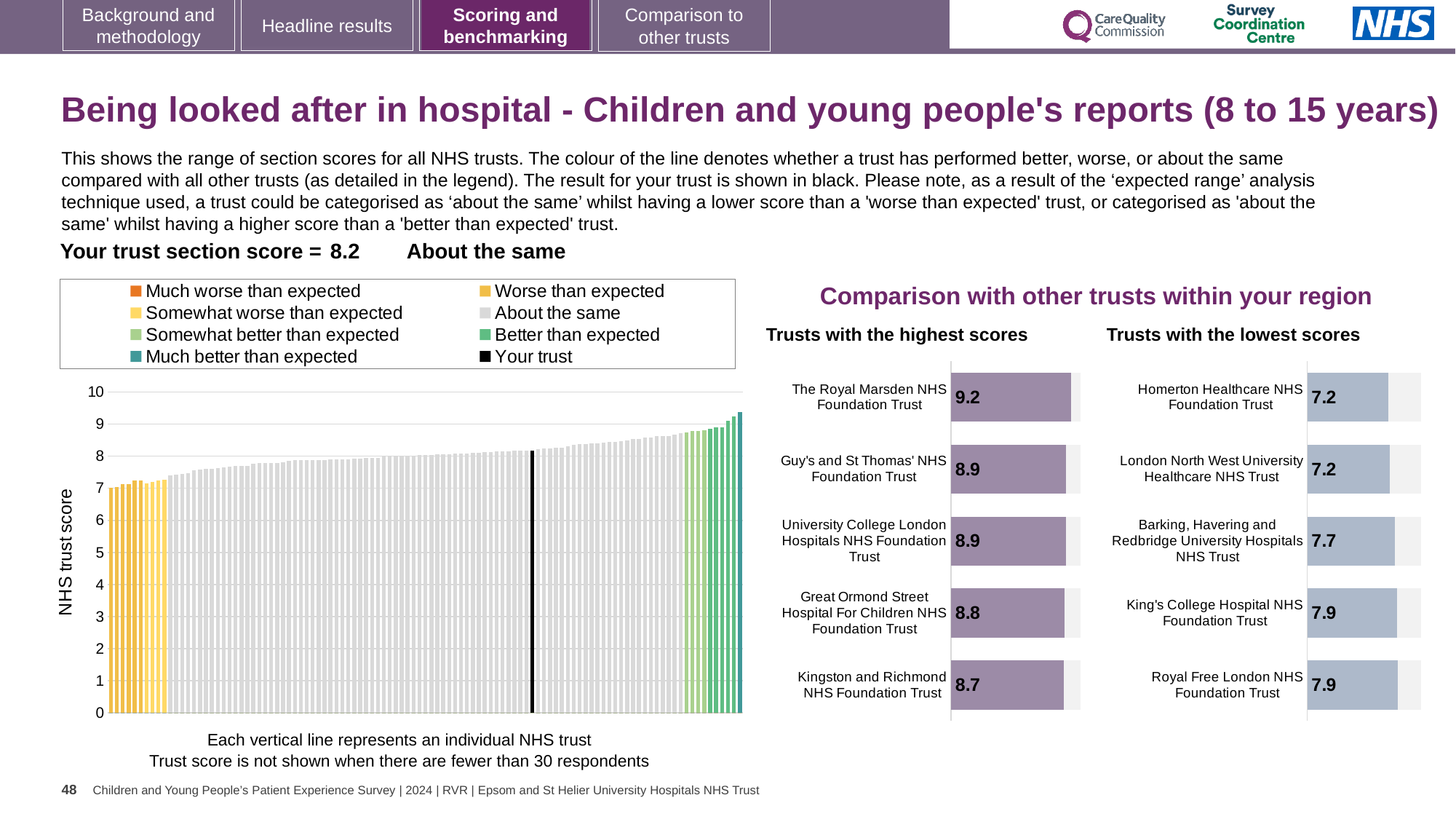
In the 'Trusts with the highest scores' chart, what is the score for Kingston and Richmond NHS Foundation Trust? 8.7 How many trusts are listed in the 'Trusts with the lowest scores' chart? 5 In the 'NHS trust score' chart on the left, do the bar values rise or fall from left to right? Rise How many entries does the legend above the 'NHS trust score' chart list? 8 In the 'NHS trust score' chart on the left, is the value of the tallest bar greater or less than 10? less In the 'Trusts with the lowest scores' chart, what is the score for Barking, Havering and Redbridge University Hospitals NHS Trust? 7.7 In the 'Trusts with the lowest scores' chart, what is the difference between the scores of Royal Free London NHS Foundation Trust and Homerton Healthcare NHS Foundation Trust? 0.7 What kind of chart is the 'NHS trust score' chart on the left of the slide? Bar chart In the 'Trusts with the highest scores' chart, what is the score for The Royal Marsden NHS Foundation Trust? 9.2 In the 'Trusts with the lowest scores' chart, which has the larger score: Barking, Havering and Redbridge University Hospitals NHS Trust or King's College Hospital NHS Foundation Trust? King's College Hospital NHS Foundation Trust In the 'Trusts with the highest scores' chart, what is the difference between the scores of The Royal Marsden NHS Foundation Trust and Kingston and Richmond NHS Foundation Trust? 0.5 In the 'Trusts with the highest scores' chart, which trust has the highest score? The Royal Marsden NHS Foundation Trust